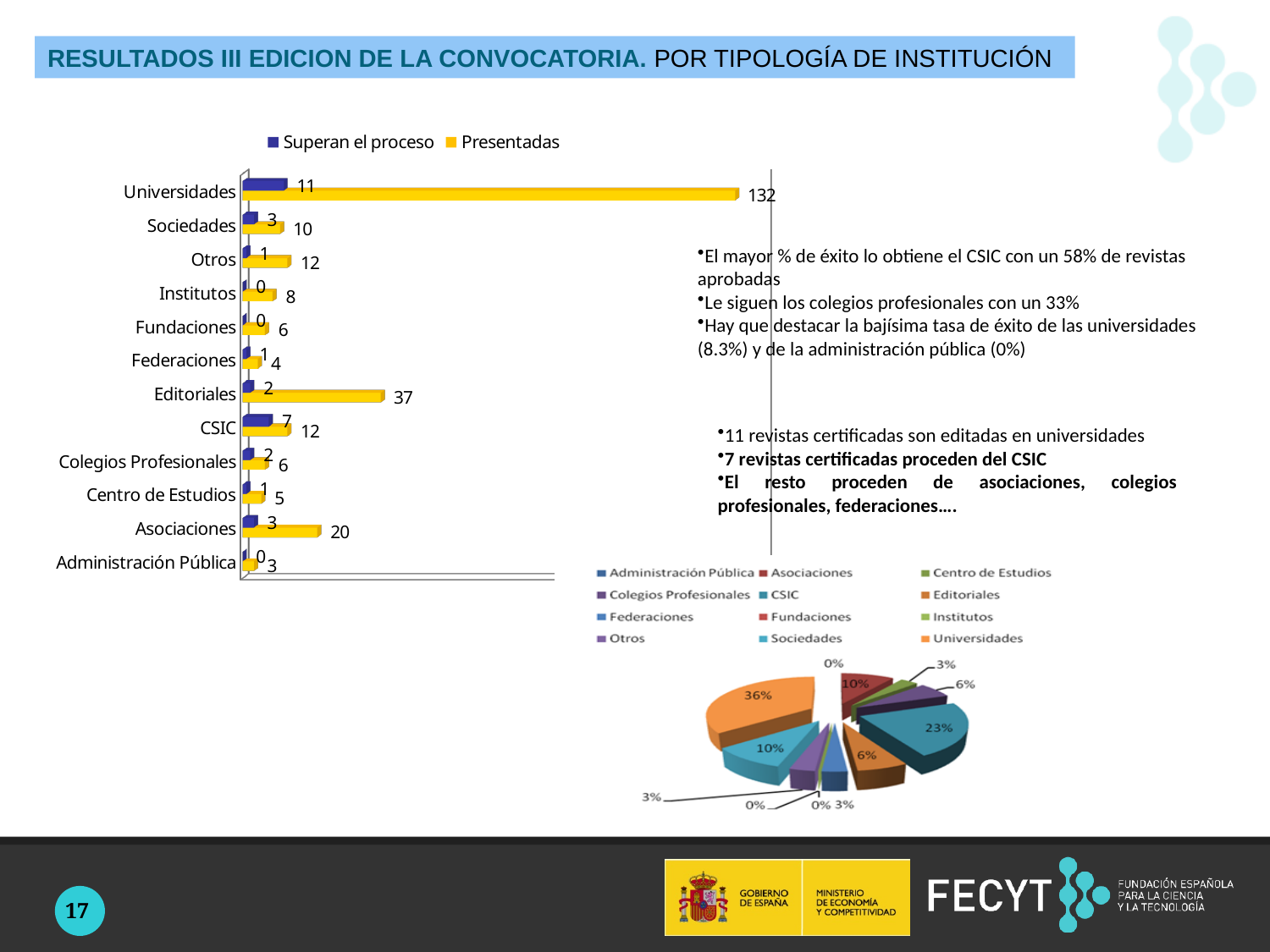
In the pie chart, what is the largest percentage label shown? 36% In the bar chart, which category has the highest 'Presentadas' value? Universidades In the bar chart, which is larger: the 'Presentadas' value for Editoriales or for Asociaciones? Editoriales In the bar chart, which category has the lowest 'Presentadas' value? Administración Pública In the bar chart, what is the 'Superan el proceso' value for CSIC? 7 In the bar chart, what is the difference between 'Presentadas' and 'Superan el proceso' for Asociaciones? 17 What type of chart is the chart on the left of the slide? Bar chart How many series does the legend of the bar chart list? 2 In the bar chart, how many journals were 'Presentadas' for Universidades? 132 What type of chart is the chart at the bottom right of the slide? Pie chart How many categories are shown in the bar chart? 12 In the bar chart, what is the 'Presentadas' value for Editoriales? 37